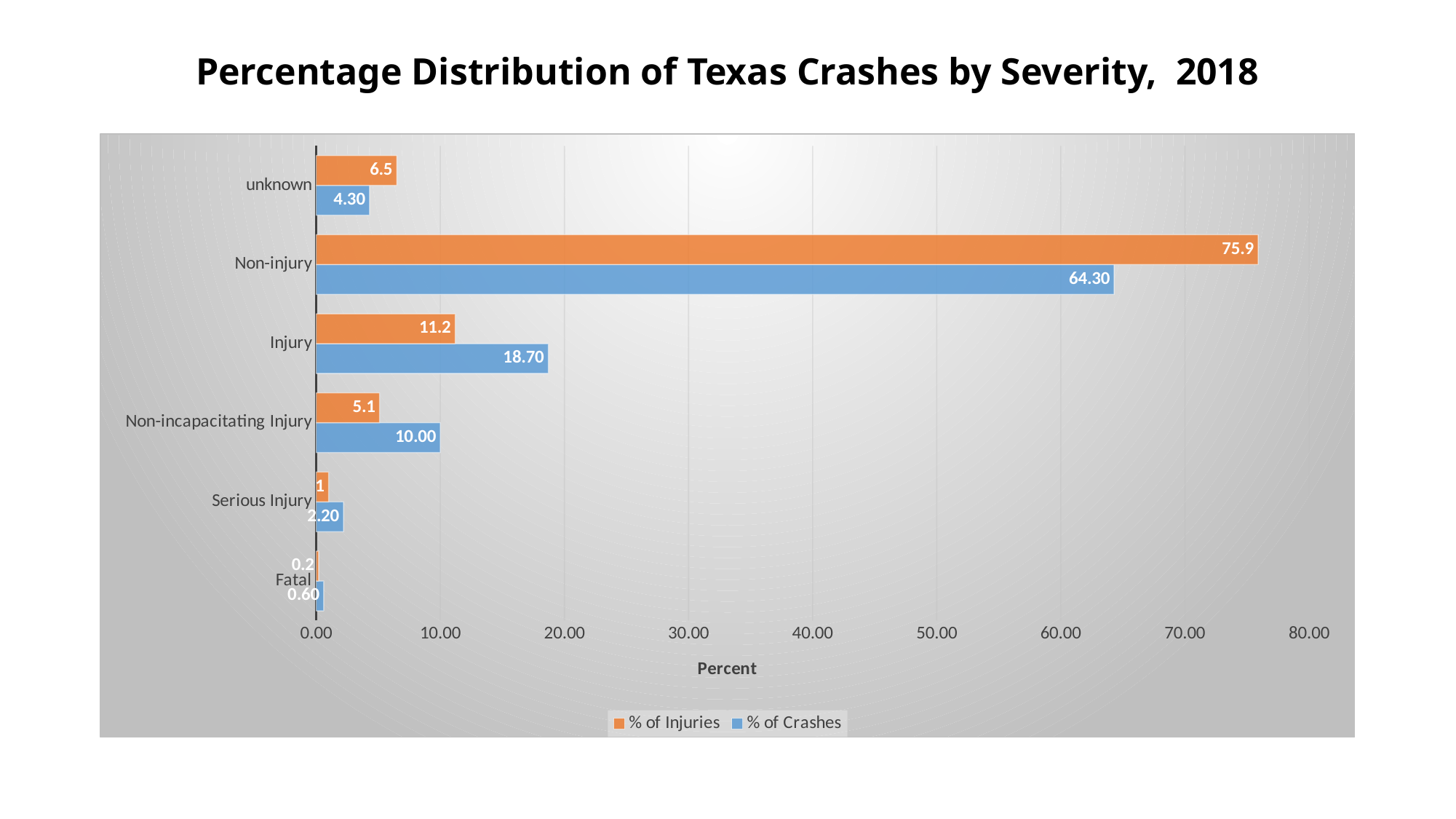
Which is larger for Injury: % of Injuries or % of Crashes? % of Crashes What is the % of Injuries value for unknown? 6.5 What is the % of Injuries value for Injury? 11.2 How many severity categories are shown on the chart? 6 Which category has the lowest % of Injuries? Fatal What is the % of Crashes value for Non-incapacitating Injury? 10.00 What is the title of the chart? Percentage Distribution of Texas Crashes by Severity, 2018 Which category has the highest % of Crashes? Non-injury What kind of chart is shown on the slide? Bar chart How many series does the legend list? 2 What is the % of Crashes value for Non-injury? 64.30 What is the difference between the % of Injuries and % of Crashes for Non-injury? 11.6